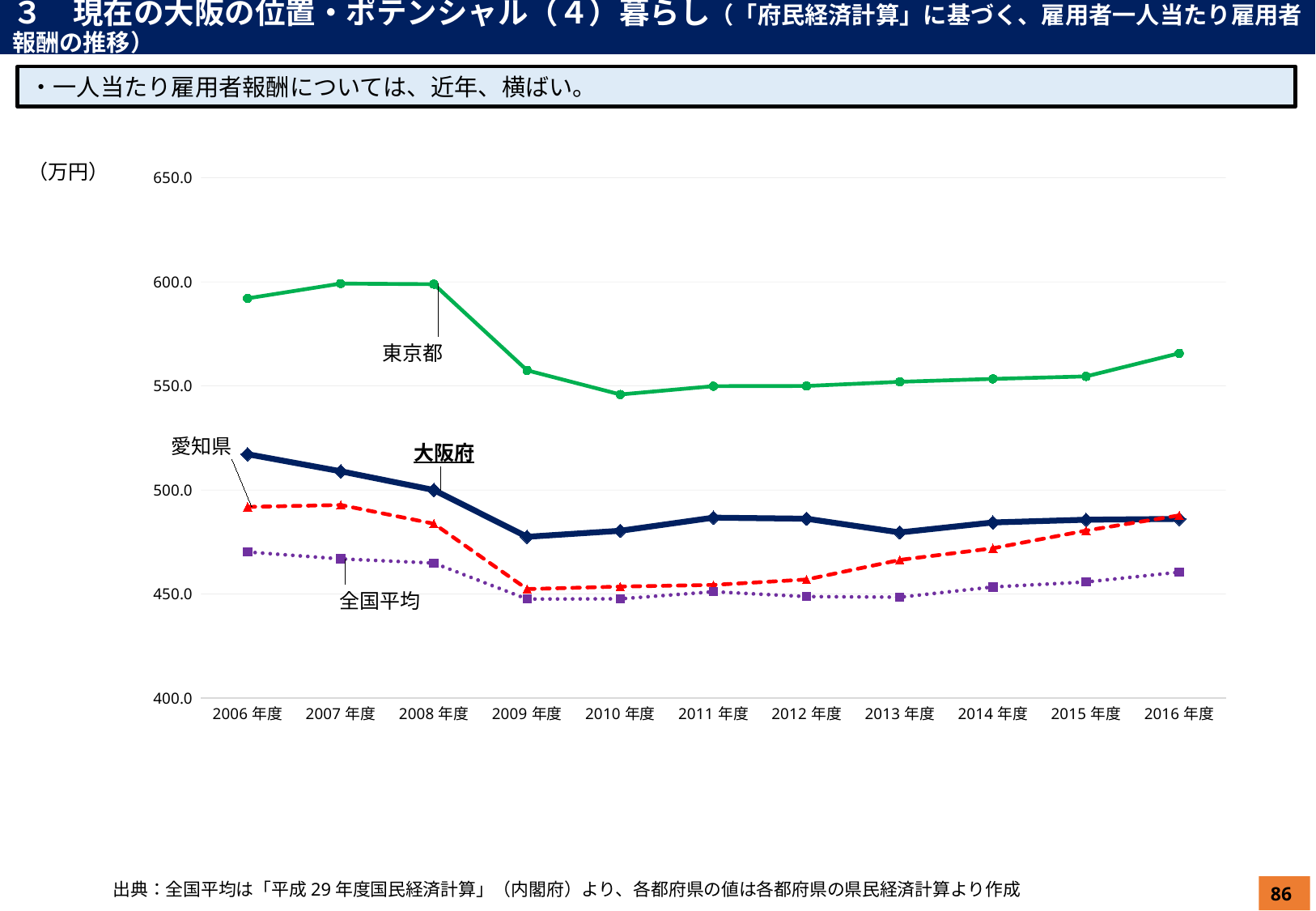
Which series has the highest value in 2016年度? 東京都 What kind of chart is shown on the slide? line chart How many fiscal years are plotted along the x axis? 11 Does the 東京都 line rise or fall from 2008年度 to 2010年度? fall In 2013年度, which is larger: the value for 大阪府 or the value for 全国平均? 大阪府 Which series has the lowest value in 2016年度? 全国平均 Is the value for 全国平均 in 2006年度 greater or less than 450? greater Is the value for 大阪府 in 2006年度 greater or less than 500? greater What unit is shown for the y axis of the chart? 万円 Is the value for 東京都 in 2006年度 greater or less than 550? greater How many series (lines) are labelled on the chart? 4